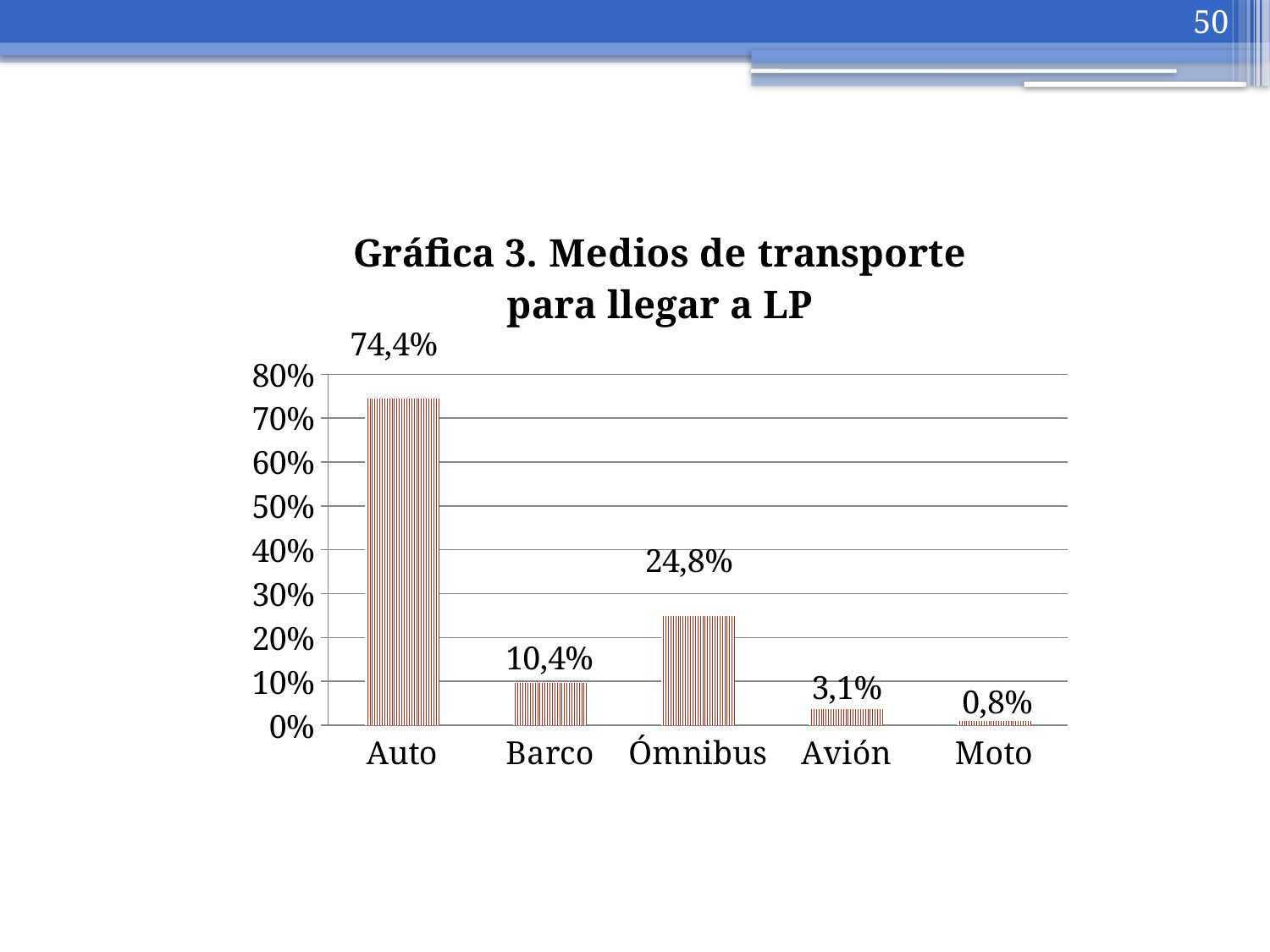
What kind of chart is shown on the slide? bar chart What is the value for Auto? 74,4% What is the difference between the values for Barco and Avión? 7,3% What is the value for Ómnibus? 24,8% What is the value for Moto? 0,8% Is the value for Auto greater or less than 70%? greater Which category has the highest value? Auto Which is larger, the value for Barco or the value for Ómnibus? Ómnibus What is the title of the chart? Gráfica 3. Medios de transporte para llegar a LP How many categories are shown on the x axis? 5 Which category has the lowest value? Moto What is the difference between the values for Auto and Ómnibus? 49,6%